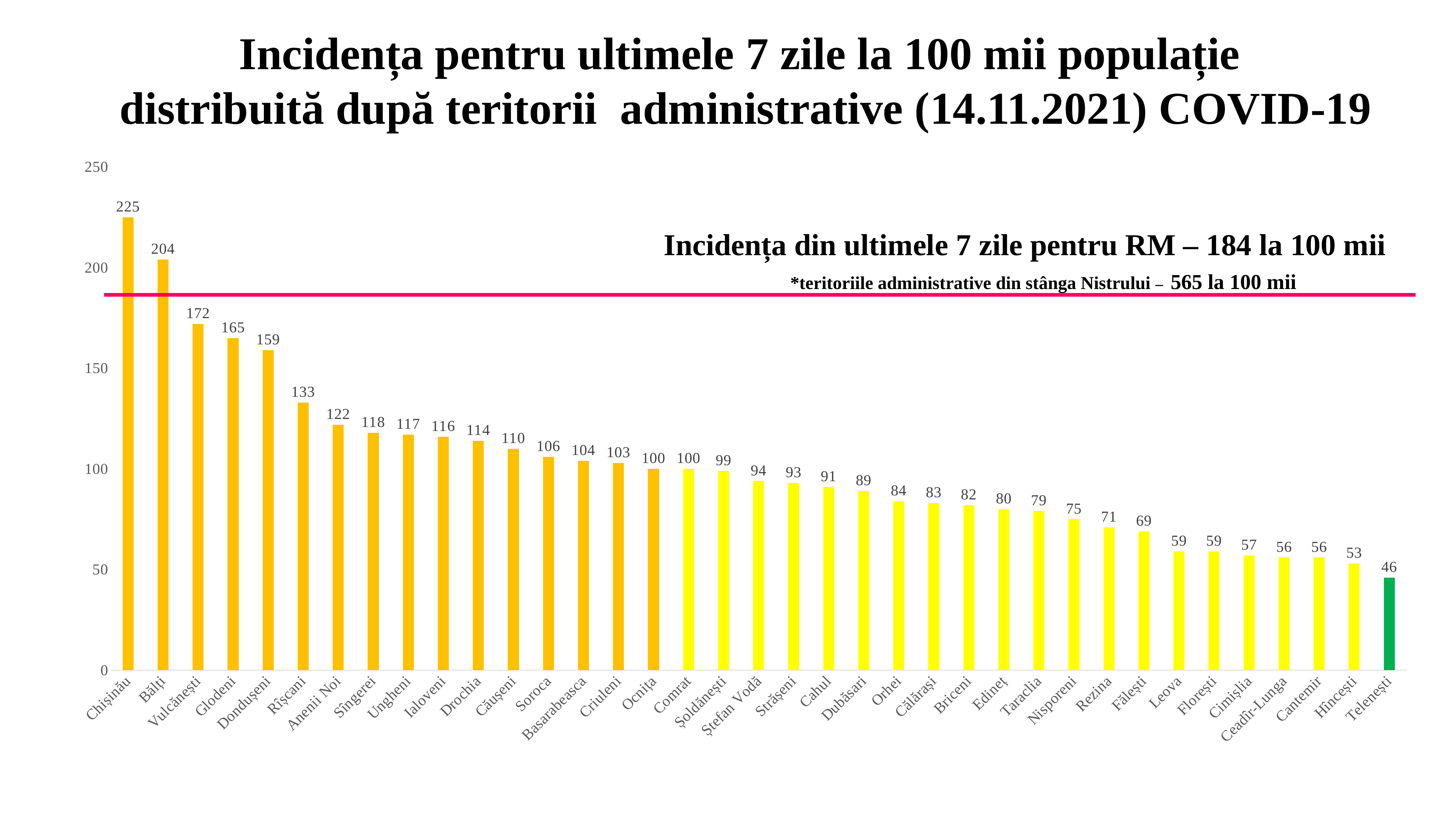
Which is larger, the value for Orhei or the value for Rezina? Orhei Do the values rise or fall from left to right along the x axis? fall Which territory has the highest value? Chișinău How many territories are shown on the chart? 37 What incidence for RM over the last 7 days is stated on the slide? 184 la 100 mii What is the value for Glodeni? 165 What is the value for Chișinău? 225 What is the value for Telenești? 46 Which territory has the lowest value? Telenești What is the value for Cahul? 91 What kind of chart is shown on the slide? bar chart What is the difference between the values for Chișinău and Bălți? 21